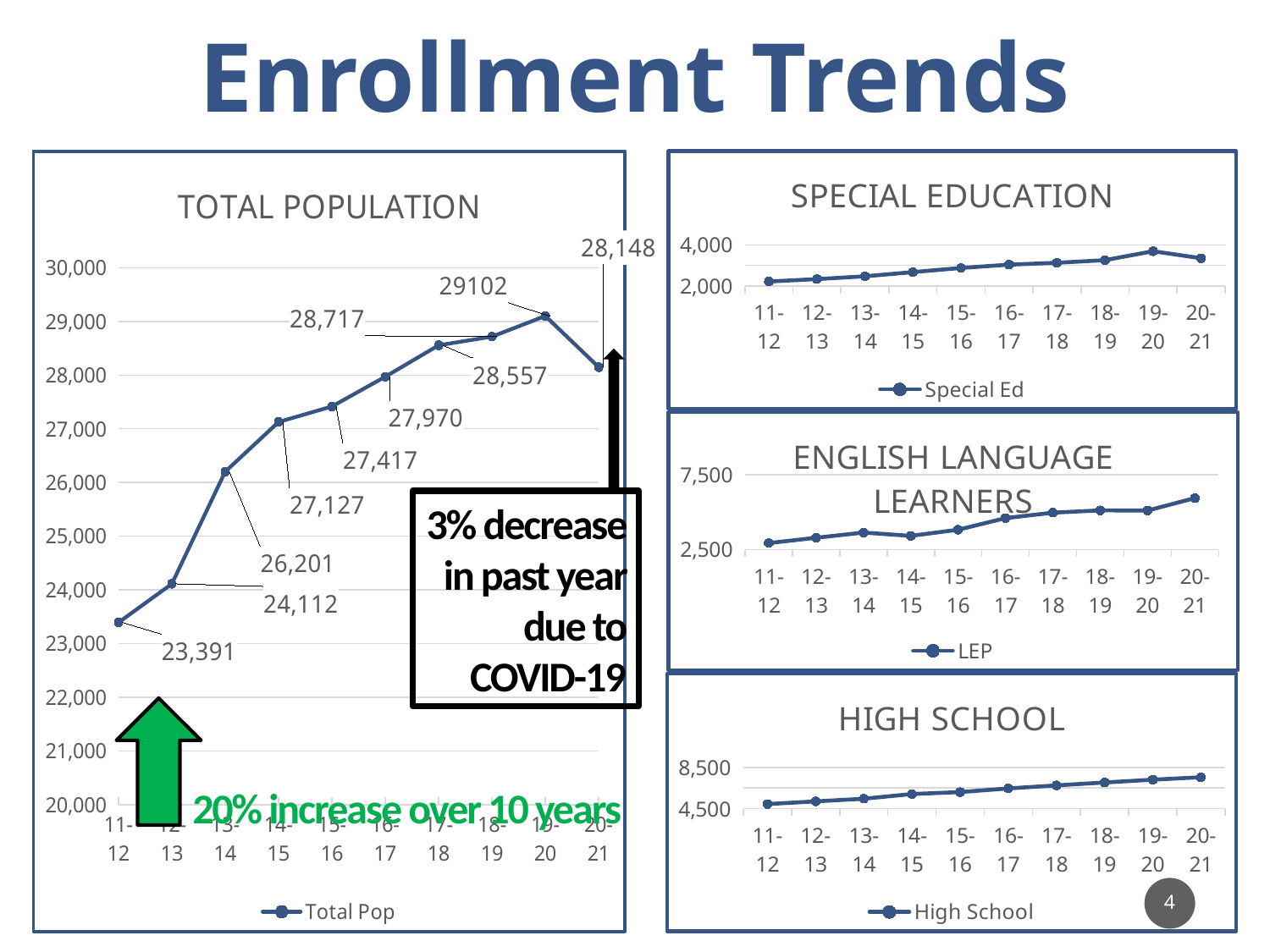
In the Total Population chart, what is the difference between the values for 19-20 and 20-21? 954 In the Total Population chart, what is the value for 16-17? 27,970 In the Total Population chart, which year has the highest value? 19-20 What series name is shown in the legend of the English Language Learners chart? LEP In the Total Population chart, which year has the lowest value? 11-12 In the Total Population chart, which is larger, the value for 13-14 or the value for 12-13? 13-14 In the Total Population chart, what is the value for 19-20? 29102 In the High School chart, do the values generally rise or fall from 11-12 to 20-21? rise In the Total Population chart, what is the value for 11-12? 23,391 In the Special Education chart, is the value for 19-20 greater or less than 2,000? greater How many data points are plotted in the Total Population chart? 10 What kind of chart is the Special Education chart? line chart